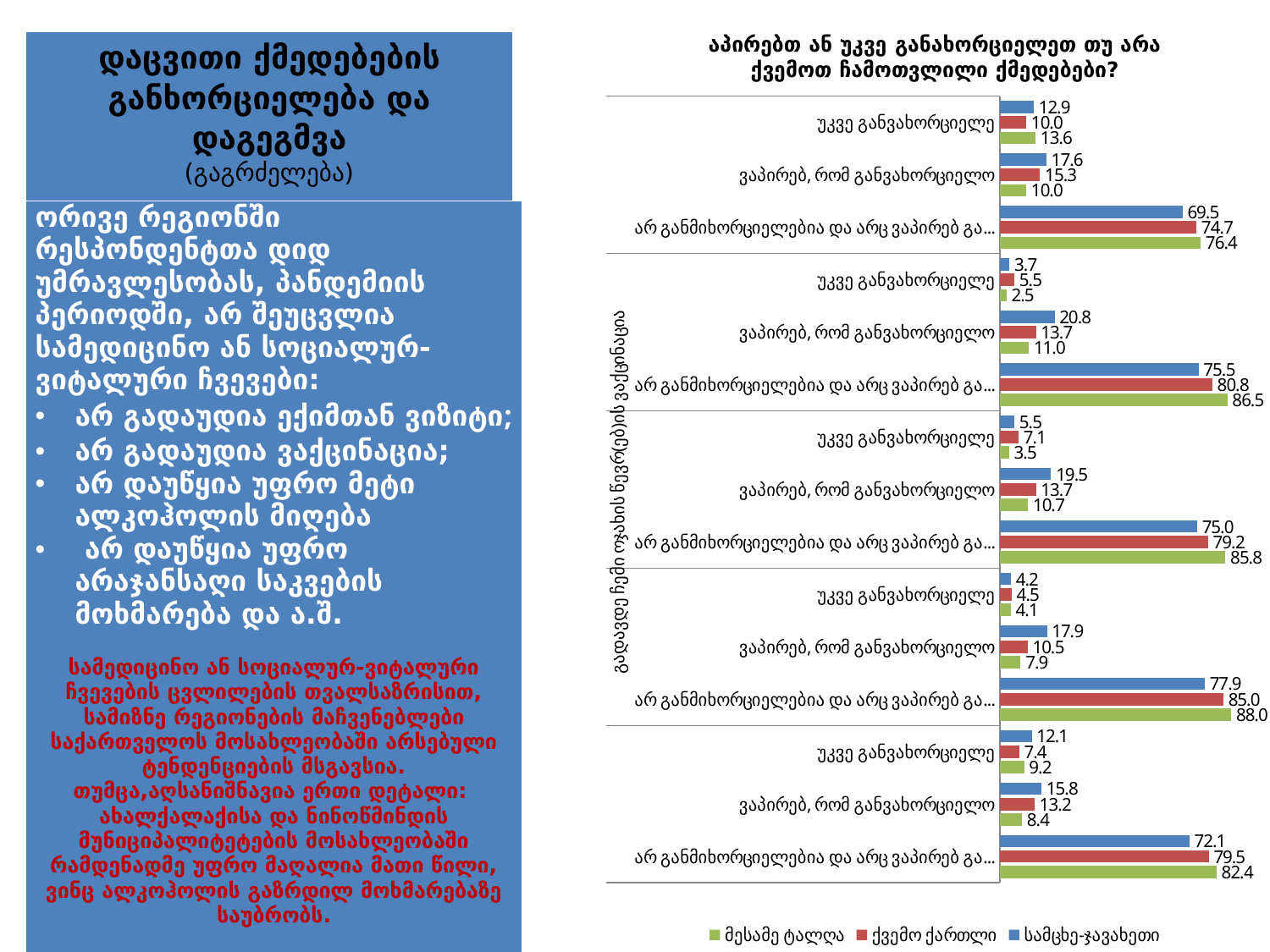
In the topmost group, what is the value for სამცხე-ჯავახეთი for 'უკვე განვახორციელე'? 12.9 How many groups of categories are shown on the vertical axis? 5 What kind of chart is shown on the slide? bar chart How many series does the legend list? 3 In the second group from the top, which series has the larger value for 'ვაპირებ, რომ განვახორციელო': სამცხე-ჯავახეთი or მესამე ტალღა? სამცხე-ჯავახეთი In the topmost group, what is the value for ქვემო ქართლი for 'არ განმიხორციელებია და არც ვაპირებ'? 74.7 What is the highest value shown anywhere on the chart? 88.0 Which series is shown in green in the legend? მესამე ტალღა In the fourth group from the top, what is the difference between მესამე ტალღა (88.0) and სამცხე-ჯავახეთი (77.9) for 'არ განმიხორციელებია და არც ვაპირებ'? 10.1 What is the lowest value shown anywhere on the chart? 2.5 In the second group from the top, what is the value for მესამე ტალღა for 'არ განმიხორციელებია და არც ვაპირებ'? 86.5 In the bottom group, what is the value for სამცხე-ჯავახეთი for 'ვაპირებ, რომ განვახორციელო'? 15.8